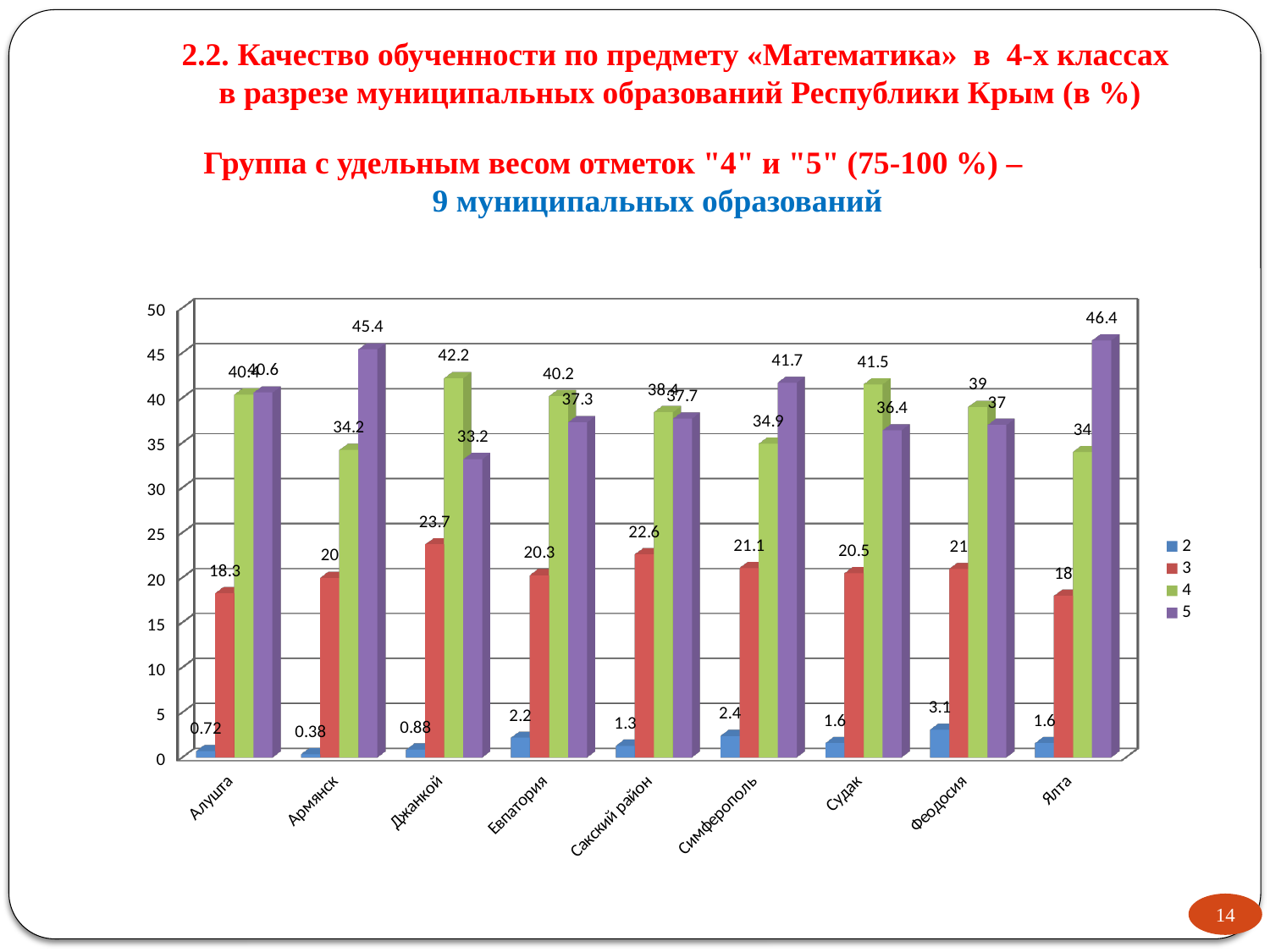
Which series is shown in green in the legend? 4 What is the value of series "2" for Армянск? 0.38 How many series does the legend list? 4 Which municipality has the lowest value for series "2"? Армянск Is the value of series "3" for Феодосия greater or less than 25? less How many municipalities (categories) are shown on the x axis? 9 Which municipality has the highest value for series "5"? Ялта Which is larger for Симферополь: the value of series "4" or the value of series "5"? series "5" What kind of chart is shown on the slide? bar chart What is the value of series "5" for Ялта? 46.4 What is the difference between the series "4" value for Джанкой and the series "4" value for Ялта? 8.2 What is the value of series "3" for Джанкой? 23.7